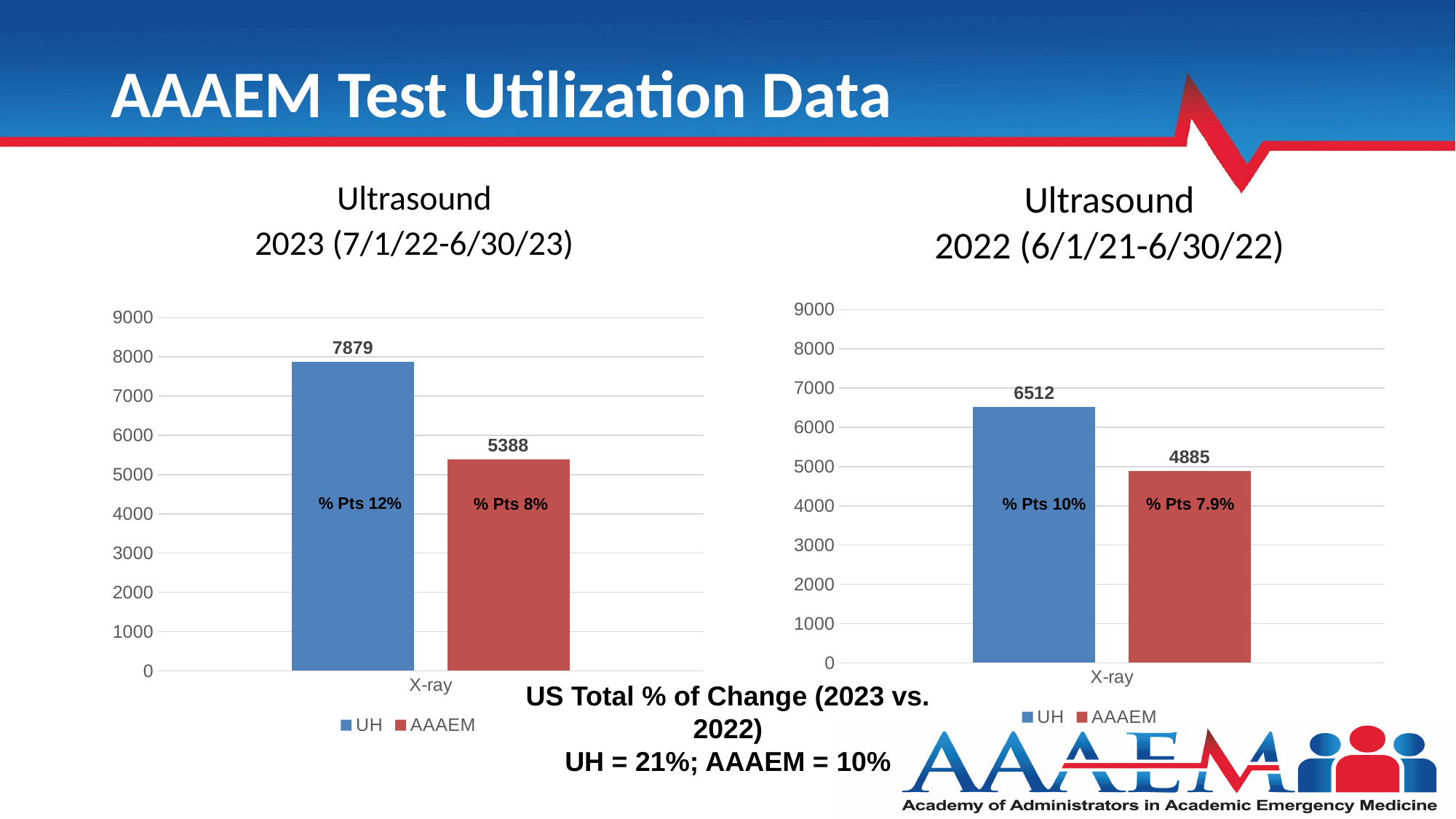
In the Ultrasound 2023 chart, what is the value for UH? 7879 What kind of chart is the Ultrasound 2022 chart? Bar chart In the Ultrasound 2023 chart, what percentage of patients label is shown on the UH bar? % Pts 12% In the Ultrasound 2022 chart, which series has the higher value, UH or AAAEM? UH In the Ultrasound 2022 chart, what is the value for AAAEM? 4885 In the Ultrasound 2023 chart, what is the value for AAAEM? 5388 In the Ultrasound 2023 chart, is the value for AAAEM greater or less than 5000? greater In the Ultrasound 2022 chart, what is the difference between the UH and AAAEM values? 1627 What is the category label on the x axis of the Ultrasound 2022 chart? X-ray In the Ultrasound 2022 chart, what is the value for UH? 6512 In the Ultrasound 2023 chart, what is the difference between the UH and AAAEM values? 2491 How many series does the legend of the Ultrasound 2023 chart list? 2